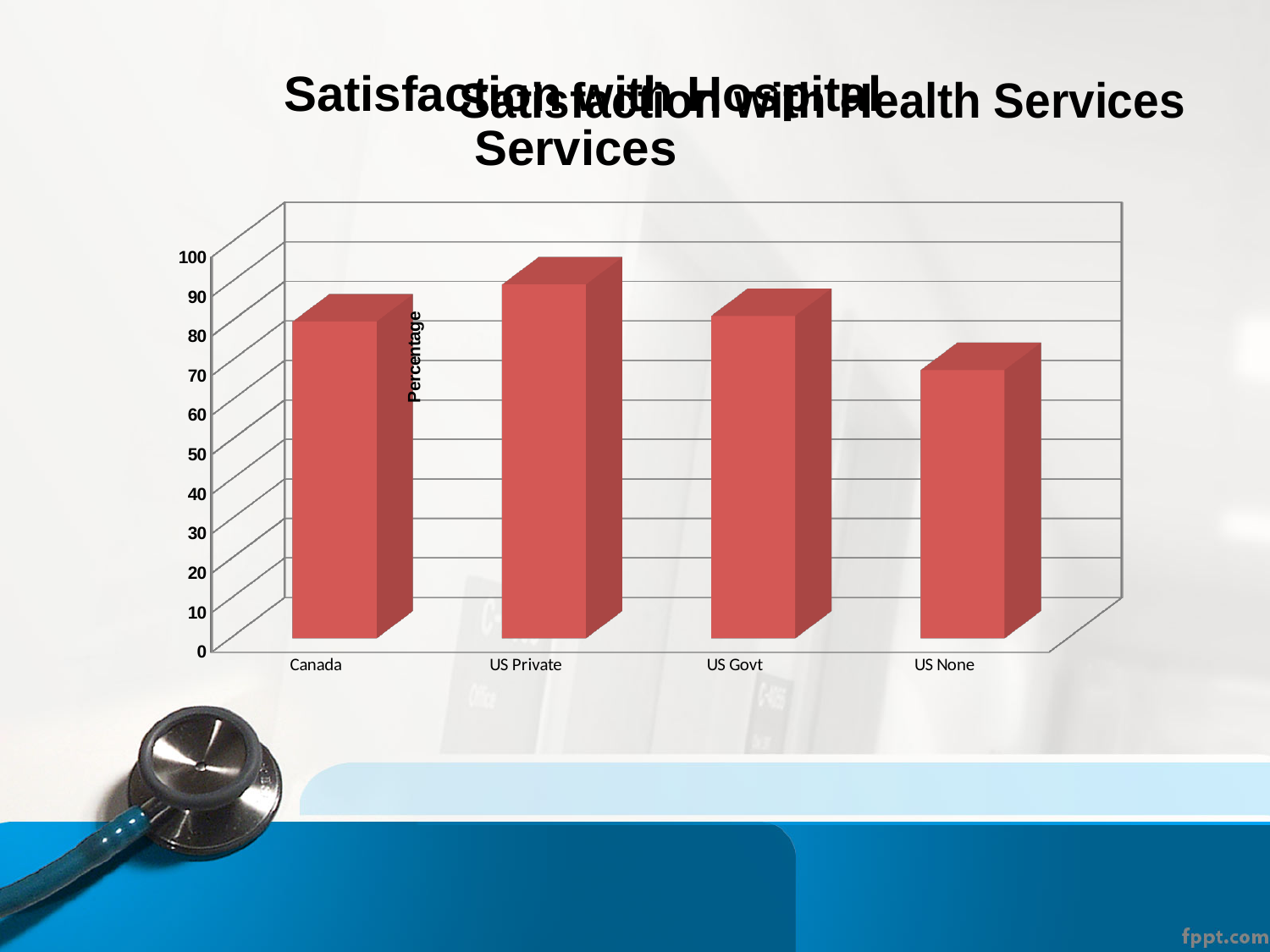
Is the value for US Private greater or less than 80? greater Is the value for US Govt greater or less than 60? greater Which category has the highest bar? US Private Is the value for US None greater or less than 80? less Which category has the lowest bar? US None What kind of chart is shown on the slide? bar chart Which is larger, the value for US Private or the value for US None? US Private What is the label on the vertical axis of the chart? Percentage How many categories are plotted on the chart? 4 Which is larger, the value for Canada or the value for US None? Canada What is the highest value shown on the vertical axis? 100